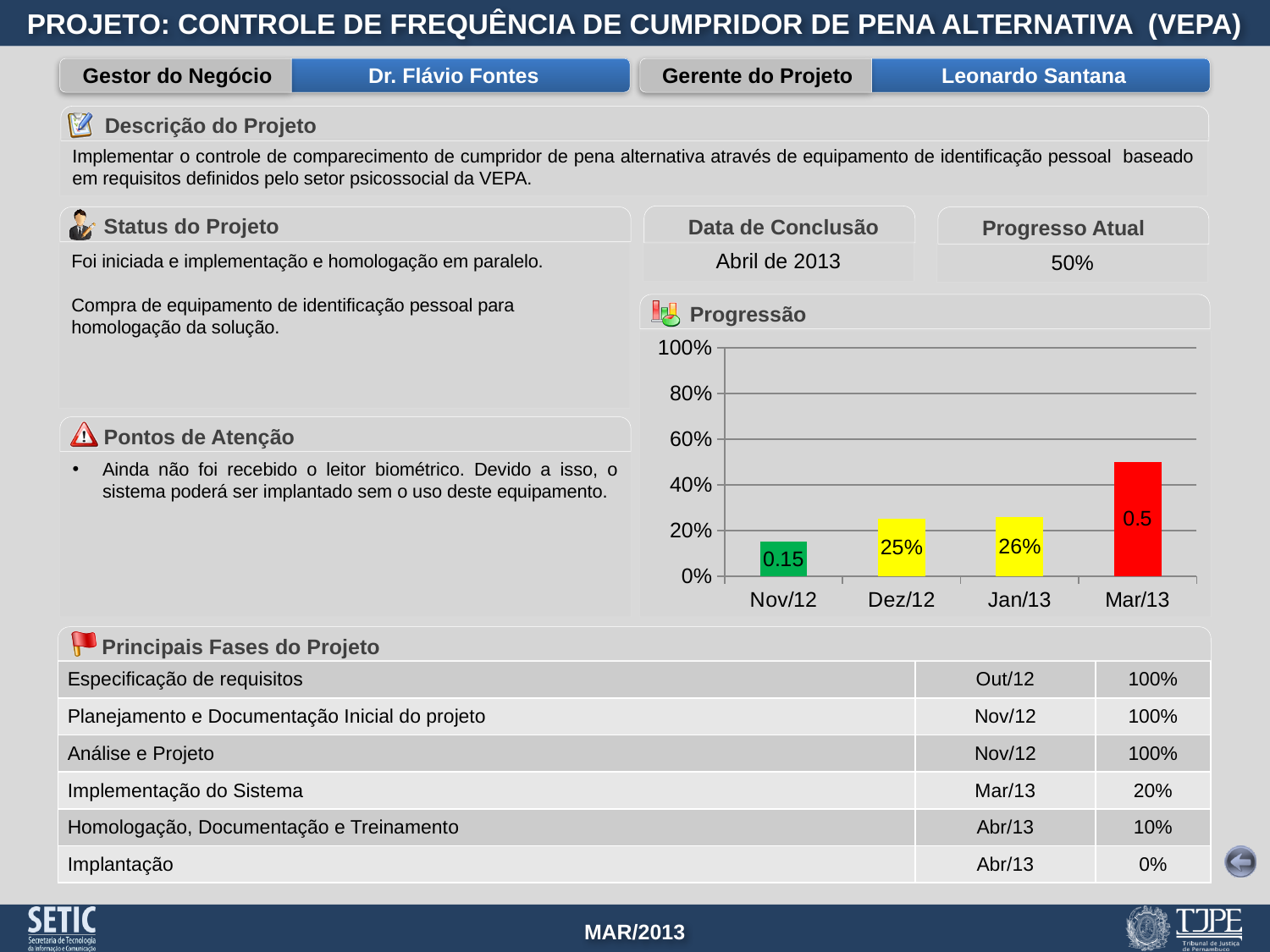
In the Progressão chart, is the value for Mar/13 greater or less than 40%? greater Do the values in the Progressão chart rise or fall from Nov/12 to Mar/13? rise In the Progressão chart, what is the difference between the values for Jan/13 and Dez/12? 1% What type of chart is shown under the "Progressão" heading? bar chart What is the value shown for Mar/13 in the Progressão chart? 0.5 How many months are plotted in the Progressão chart? 4 What is the value shown for Nov/12 in the Progressão chart? 0.15 Which month has the lowest bar in the Progressão chart? Nov/12 What is the value shown for Jan/13 in the Progressão chart? 26% Which month has the highest bar in the Progressão chart? Mar/13 What is the value shown for Dez/12 in the Progressão chart? 25% What colour is the Mar/13 bar in the Progressão chart? red